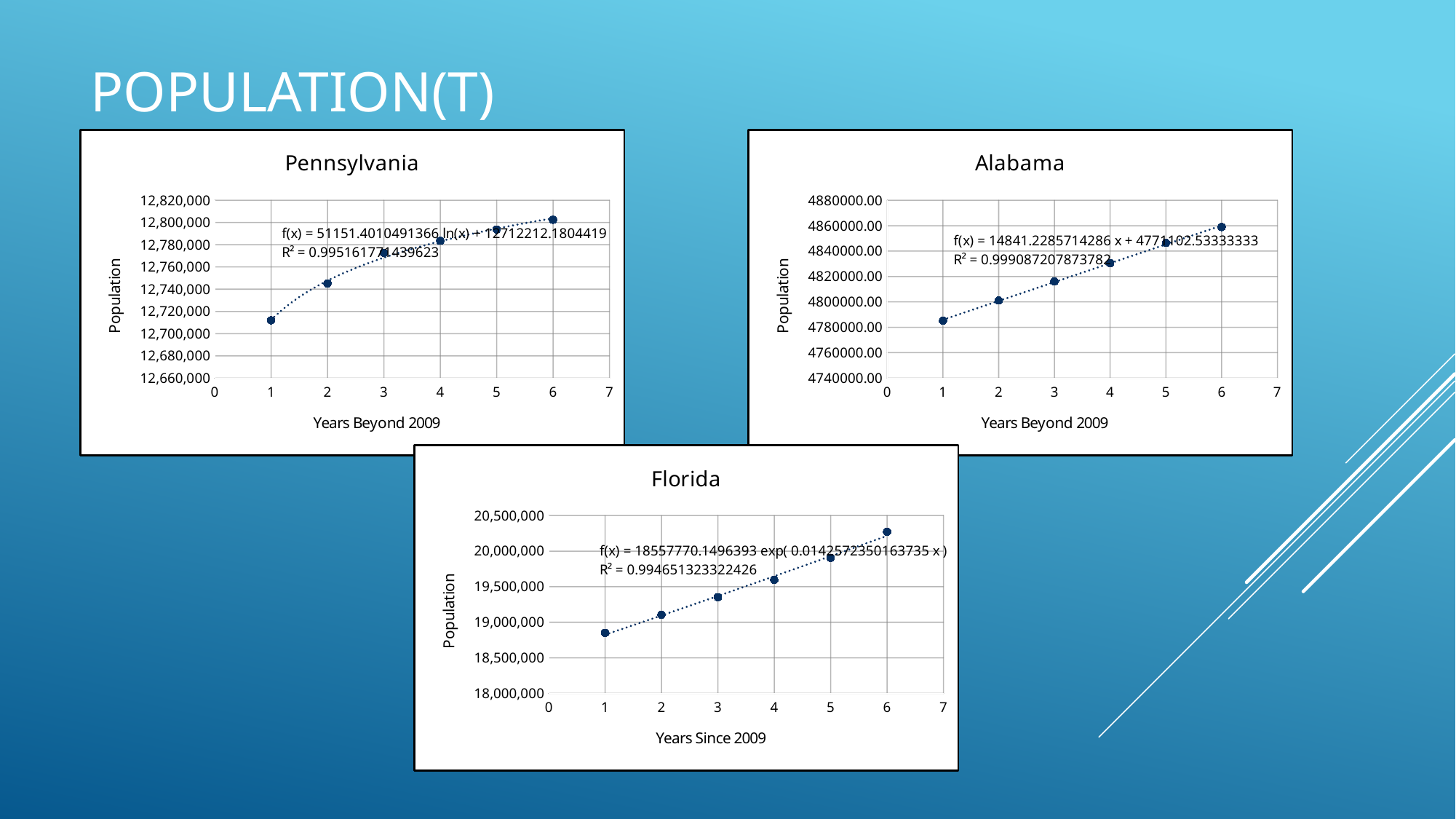
On the Pennsylvania chart, is the population at year 1 greater or less than 12,720,000? less On the Florida chart, which year since 2009 has the lowest population? 1 On the Alabama chart, do the population values rise or fall as years beyond 2009 increase? Rise On the Alabama chart, is the population at year 5 greater or less than 4840000.00? greater What R² value is shown on the Alabama chart? 0.999087207873782 On the Florida chart, is the population at year 1 greater or less than 19,000,000? less How many data points are plotted on the Florida chart? 6 What kind of chart is the Pennsylvania chart? Scatter chart What is the x-axis title of the Florida chart? Years Since 2009 On the Pennsylvania chart, which year beyond 2009 has the highest population? 6